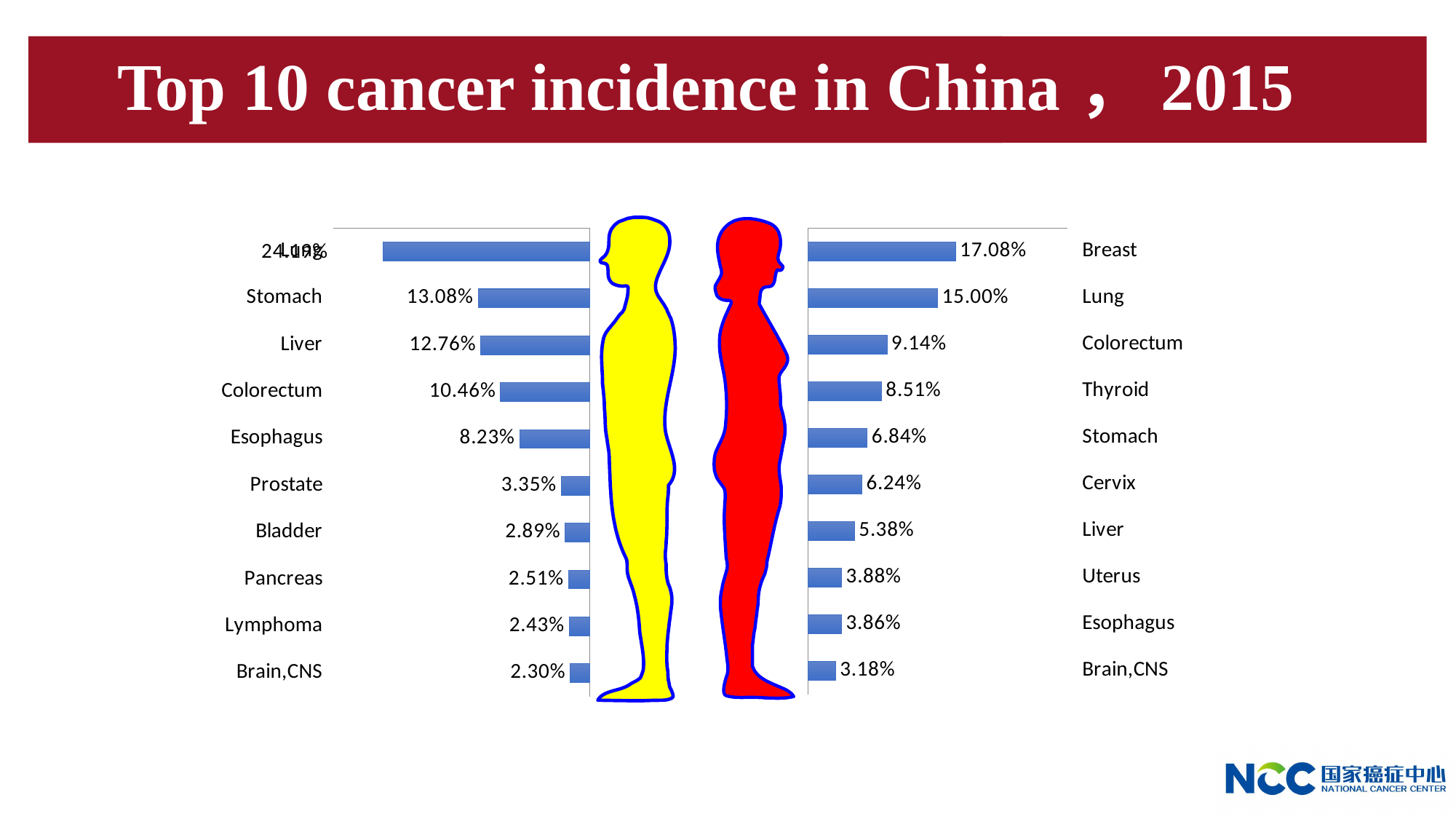
In the right chart, which category has the lowest value? Brain,CNS In the right chart, what is the value for Breast? 17.08% In the right chart, what is the value for Thyroid? 8.51% In the right chart, what is the difference between the values for Breast and Lung? 2.08% In the left chart, what is the difference between the values for Stomach and Liver? 0.32% In the left chart, what is the value for Stomach? 13.08% How many categories are shown in the right chart? 10 In the left chart, which is larger, the value for Colorectum or the value for Esophagus? Colorectum In the left chart, which category has the lowest value? Brain,CNS In the left chart, what is the value for Prostate? 3.35% What kind of chart is the left chart? Bar chart In the right chart, which category has the highest value? Breast